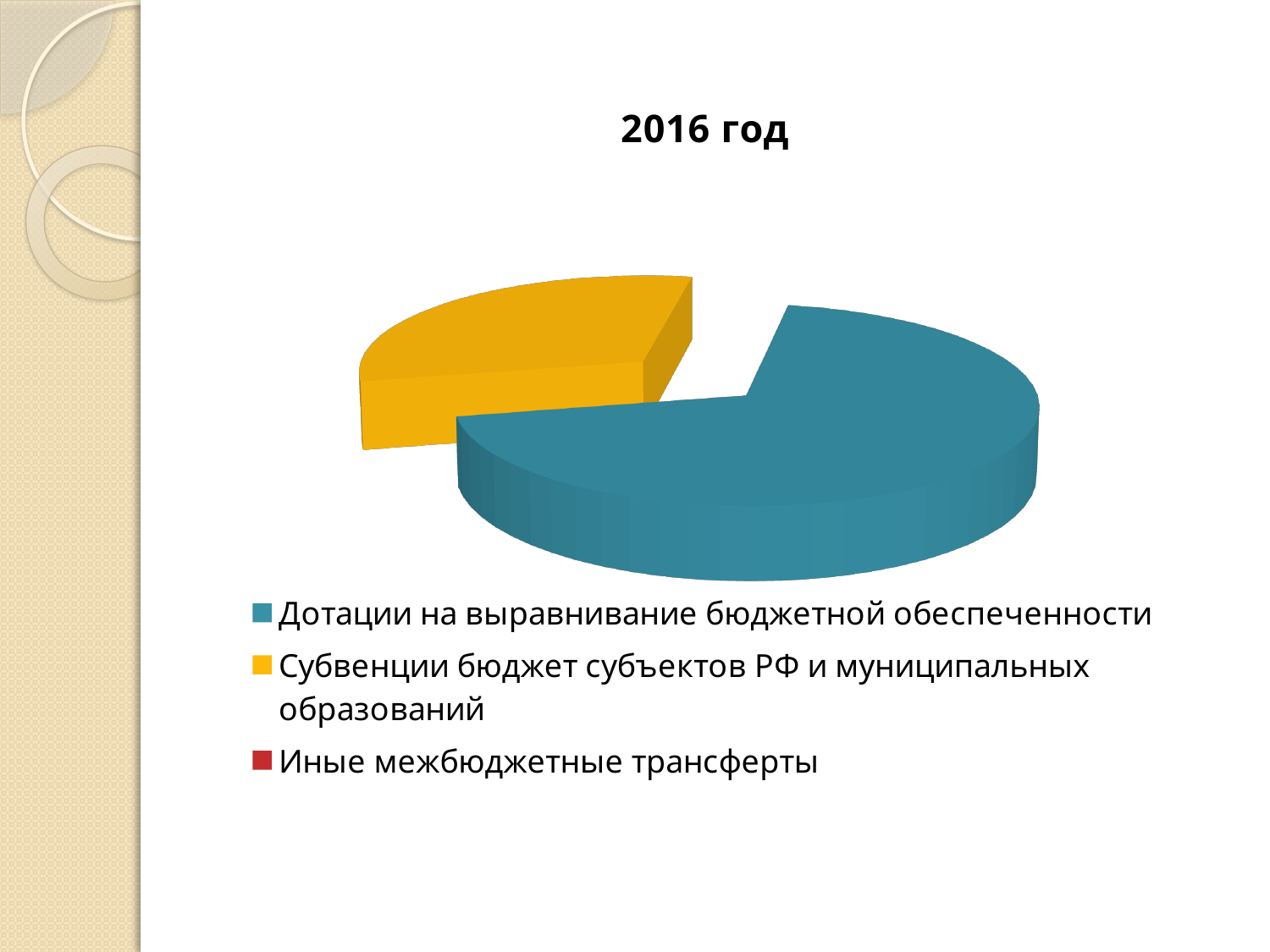
Does the slice for Субвенции бюджет субъектов РФ и муниципальных образований take up more or less than half of the pie? less Which slice is larger: Дотации на выравнивание бюджетной обеспеченности or Субвенции бюджет субъектов РФ и муниципальных образований? Дотации на выравнивание бюджетной обеспеченности Which colour represents Субвенции бюджет субъектов РФ и муниципальных образований in the chart? yellow Does the slice for Дотации на выравнивание бюджетной обеспеченности take up more or less than half of the pie? more How many entries does the chart's legend list? 3 Which category has the largest slice of the pie? Дотации на выравнивание бюджетной обеспеченности What kind of chart is shown on the slide? pie chart What is the title of the chart? 2016 год